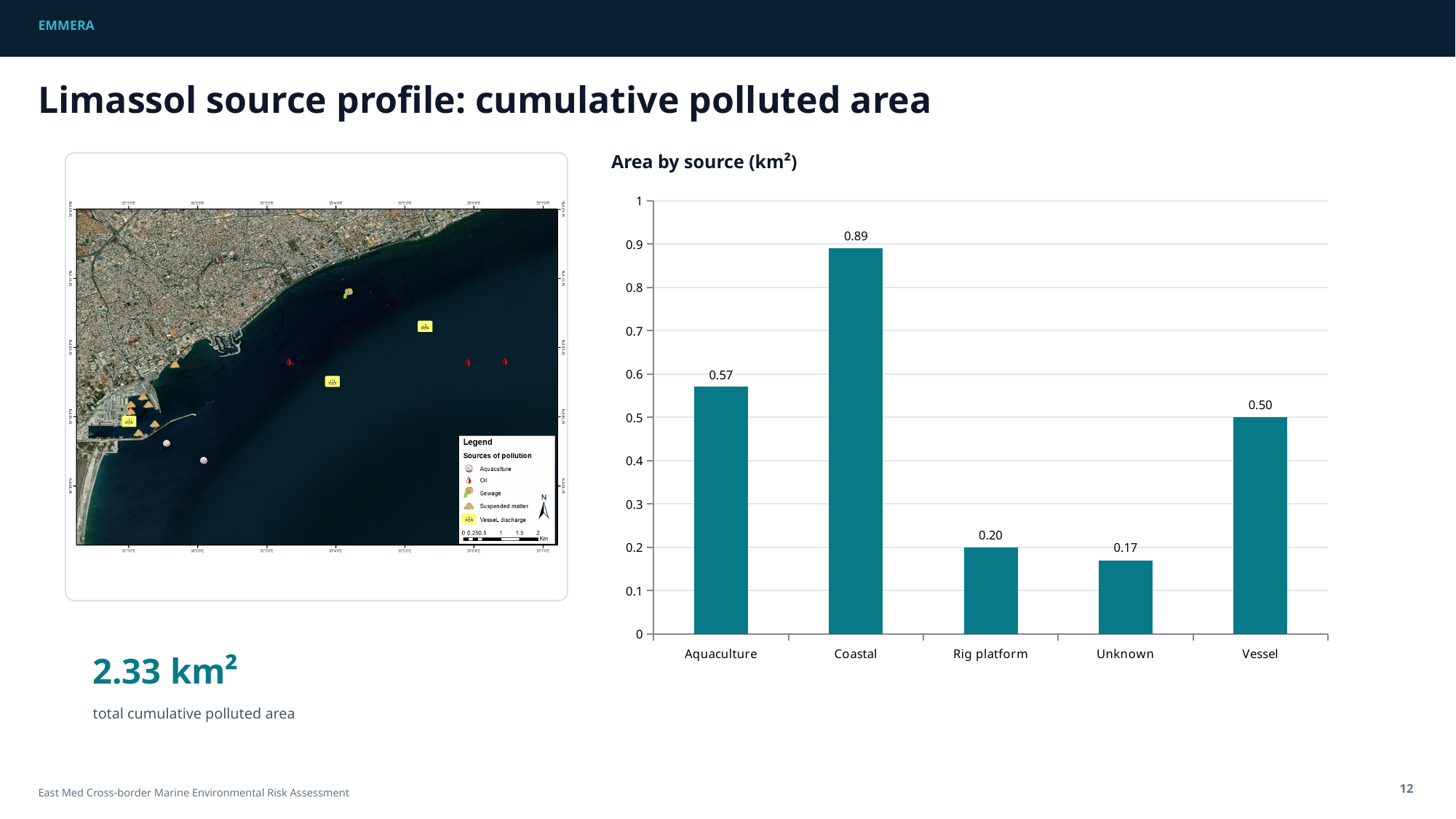
What is the value for Aquaculture in the Area by source (km²) chart? 0.57 How many source categories are shown in the Area by source (km²) chart? 5 Is the value for Vessel in the Area by source (km²) chart greater or less than 0.6? less What is the value for Unknown in the Area by source (km²) chart? 0.17 Which source has the highest area in the Area by source (km²) chart? Coastal Which is larger in the Area by source (km²) chart, Aquaculture or Vessel? Aquaculture What kind of chart is the Area by source (km²) chart? bar chart What is the difference between the Coastal and Vessel values in the Area by source (km²) chart? 0.39 Which source has the lowest area in the Area by source (km²) chart? Unknown What is the title of the chart on the right of the slide? Area by source (km²) What is the value for Coastal in the Area by source (km²) chart? 0.89 What is the difference between the Rig platform and Unknown values in the Area by source (km²) chart? 0.03